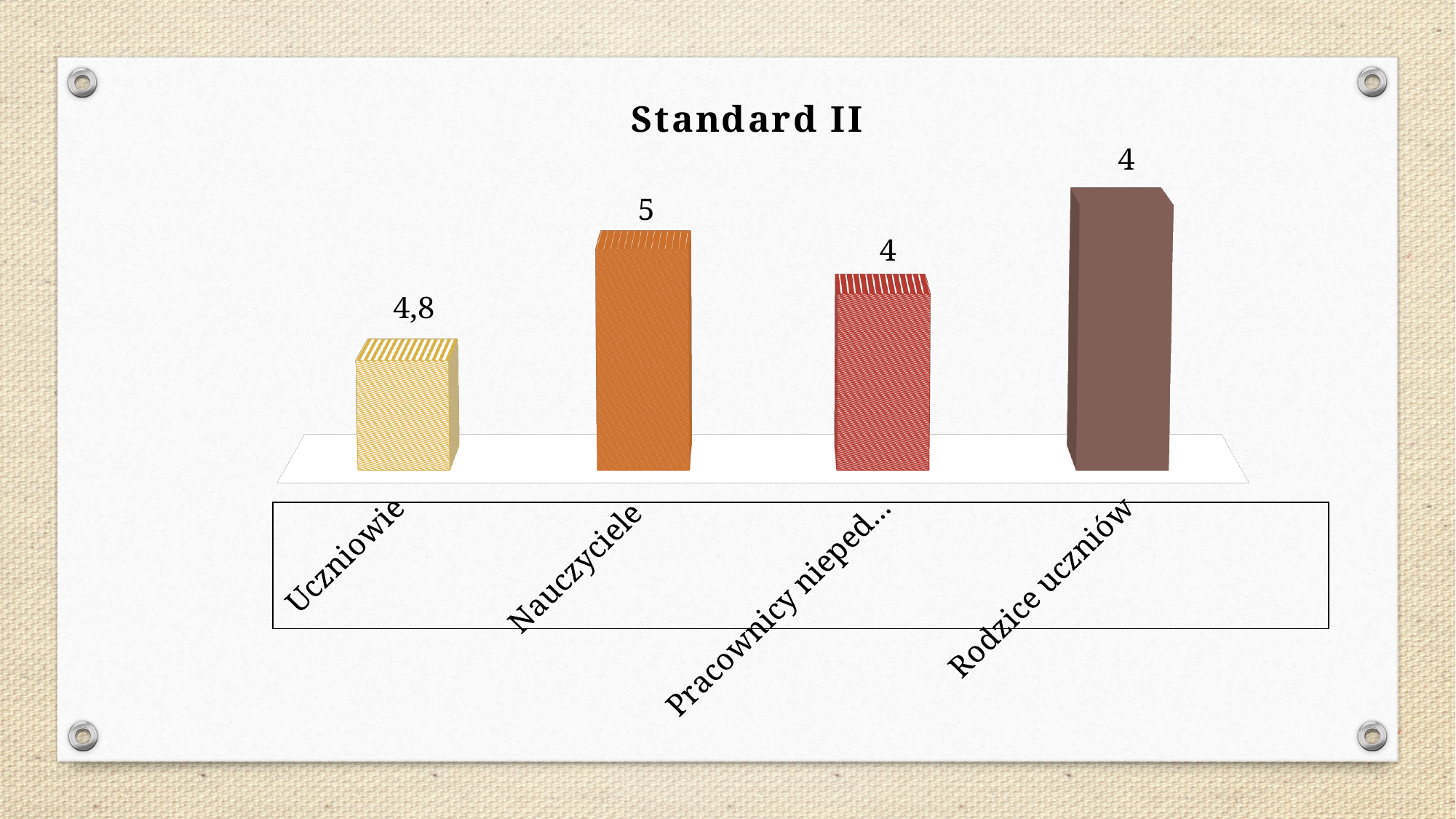
What type of chart is shown on the slide? bar chart What is the title of the chart? Standard II What is the value for Nauczyciele? 5 What is the value for Uczniowie? 4,8 What is the difference between the value for Nauczyciele and the value for "Pracownicy nieped..."? 1 What is the label of the first category on the left of the chart? Uczniowie What is the value for Rodzice uczniów? 4 How many categories are shown in the chart? 4 What is the value for the category labelled "Pracownicy nieped..."? 4 Which is larger, the value for Nauczyciele or the value for "Pracownicy nieped..."? Nauczyciele What is the difference between the value for Nauczyciele and the value for Uczniowie? 0,2 Which is larger, the value for Nauczyciele or the value for Uczniowie? Nauczyciele